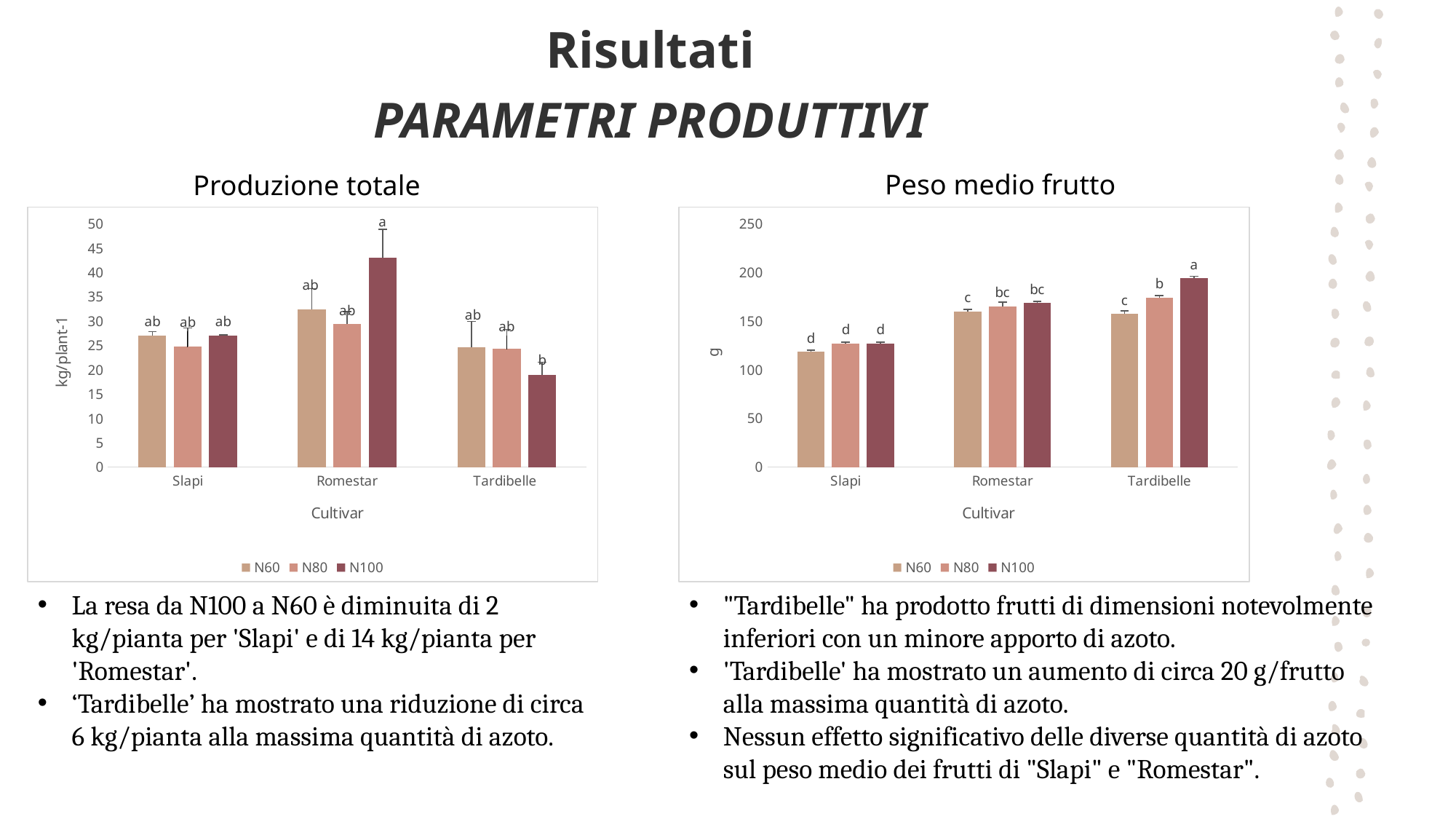
In the 'Peso medio frutto' chart, which cultivar has the highest N100 bar? Tardibelle How many cultivars are shown on the x axis of the 'Produzione totale' chart? 3 What is the y-axis label of the 'Produzione totale' chart? kg/plant-1 In the 'Peso medio frutto' chart, which cultivar and series has the lowest bar? Slapi, N60 In the 'Peso medio frutto' chart, is the N60 value for Slapi greater or less than 150? less In the 'Produzione totale' chart, is the N100 value for Tardibelle greater or less than 25? less What kind of chart is the 'Produzione totale' chart? bar chart In the 'Produzione totale' chart, which is larger: the N60 value for Romestar or the N60 value for Tardibelle? Romestar In the 'Produzione totale' chart, which cultivar has the highest N100 bar? Romestar How many series does the legend of the 'Peso medio frutto' chart list? 3 In the 'Peso medio frutto' chart, is the N100 value for Tardibelle greater or less than 150? greater